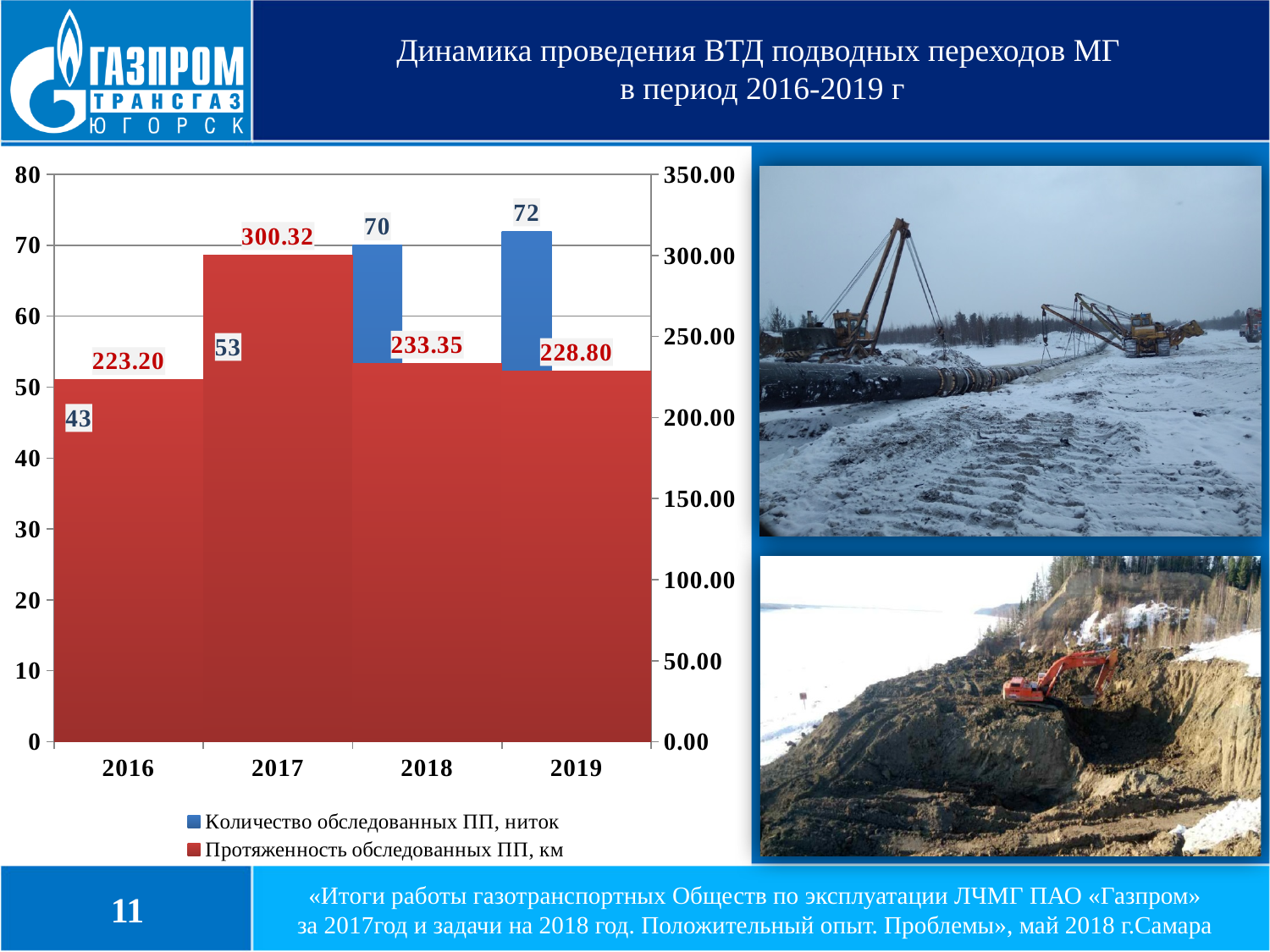
What is the value of «Протяженность обследованных ПП, км» for 2019? 228.80 In which year is «Количество обследованных ПП, ниток» the highest? 2019 What type of chart is shown on the slide? bar chart Is the value of «Протяженность обследованных ПП, км» for 2017 greater or less than 250.00? greater How many series does the chart legend list? 2 Does «Количество обследованных ПП, ниток» rise or fall from 2016 to 2019? rise Which year has the larger «Протяженность обследованных ПП, км»: 2018 or 2019? 2018 In which year is «Протяженность обследованных ПП, км» the lowest? 2016 What is the value of «Протяженность обследованных ПП, км» for 2017? 300.32 What is the difference in «Количество обследованных ПП, ниток» between 2019 and 2016? 29 What is the value of «Количество обследованных ПП, ниток» for 2018? 70 How many years are shown on the x axis of the chart? 4